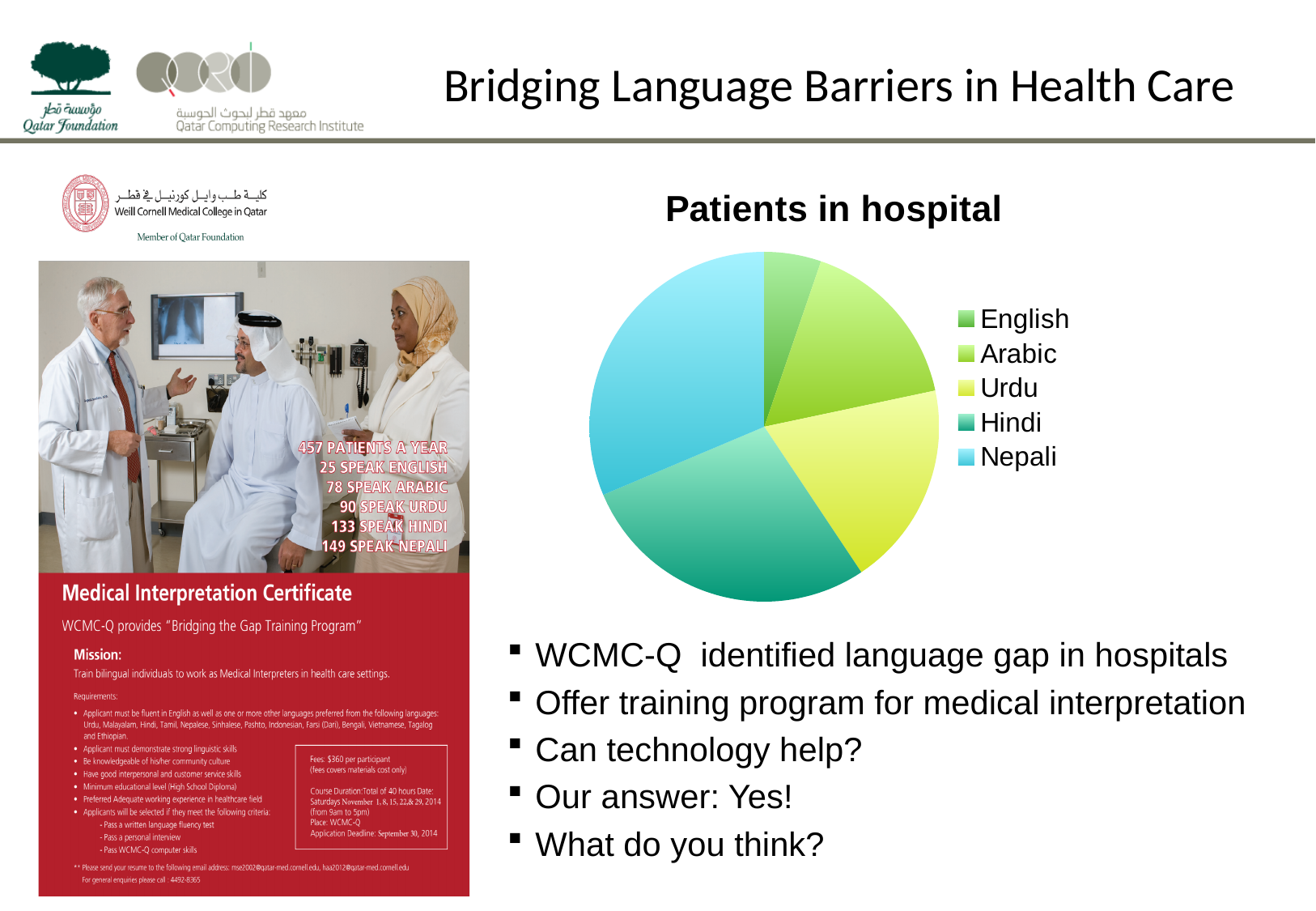
Which slice is larger, Hindi or Urdu? Hindi Which slice is larger, English or Arabic? Arabic Which legend entry is listed first in the chart legend? English Which slice is larger, Hindi or Arabic? Hindi What is the title of the chart? Patients in hospital Which language group has the smallest slice of the pie? English How many categories does the pie chart show? 5 How many entries does the chart legend list? 5 Which language group has the largest slice of the pie? Nepali What kind of chart is shown on the slide? pie chart